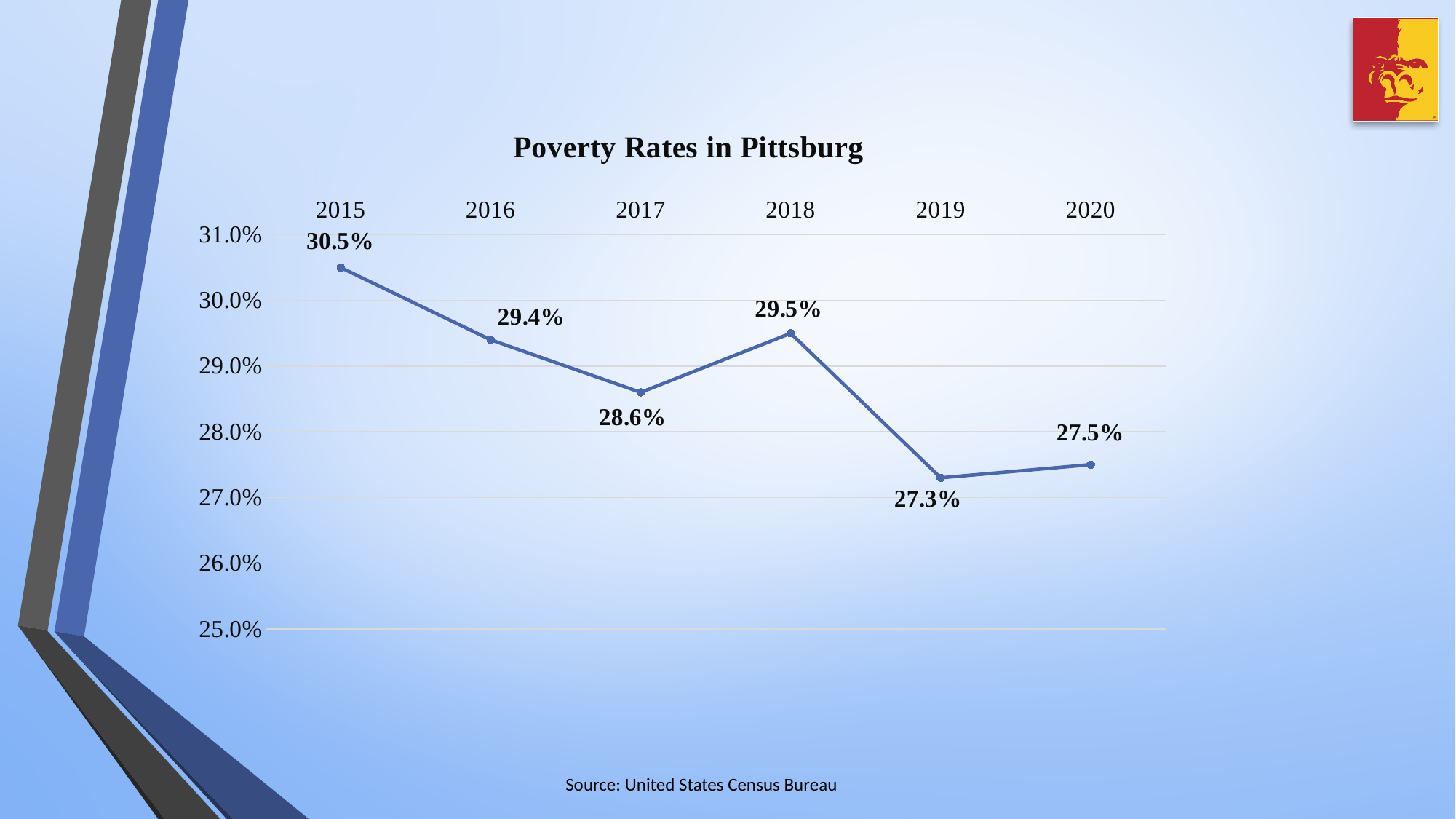
Which year has a higher poverty rate, 2016 or 2017? 2016 How many years are plotted on the chart? 6 Is the poverty rate for 2019 greater or less than 28.0%? less What is the poverty rate in Pittsburg for 2020? 27.5% Which year has the highest poverty rate? 2015 What is the difference between the poverty rates in 2017 and 2018? 0.9% What is the title of the chart? Poverty Rates in Pittsburg What is the poverty rate in Pittsburg for 2018? 29.5% What is the poverty rate in Pittsburg for 2015? 30.5% Which year has the lowest poverty rate? 2019 What is the difference between the poverty rates in 2015 and 2020? 3.0% What kind of chart is shown on the slide? line chart